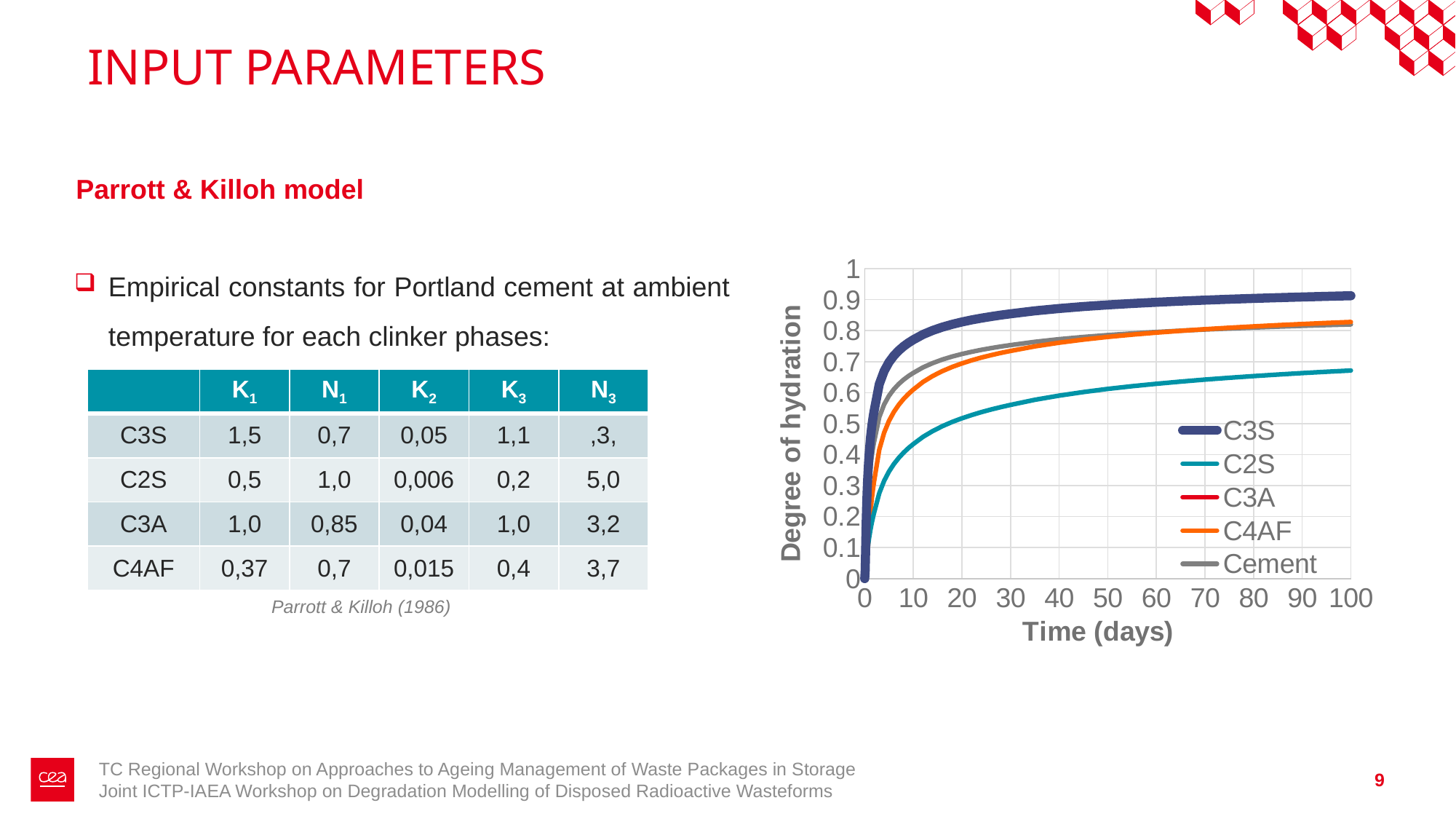
Is the degree of hydration for C2S at 100 days greater or less than 0.8? less What kind of chart is shown on the slide? line chart At 20 days, which series has the larger degree of hydration, Cement or C2S? Cement Does the degree of hydration for C3S rise or fall as time increases? rise Is the degree of hydration for C4AF at 100 days greater or less than 0.7? greater How many series does the chart legend list? 5 What is the title of the chart's vertical axis? Degree of hydration Is the degree of hydration for C3S at 100 days greater or less than 0.8? greater At 50 days, which series has the larger degree of hydration, C3S or C2S? C3S What is the title of the chart's horizontal axis? Time (days) Which series has the lowest degree of hydration at 100 days? C2S